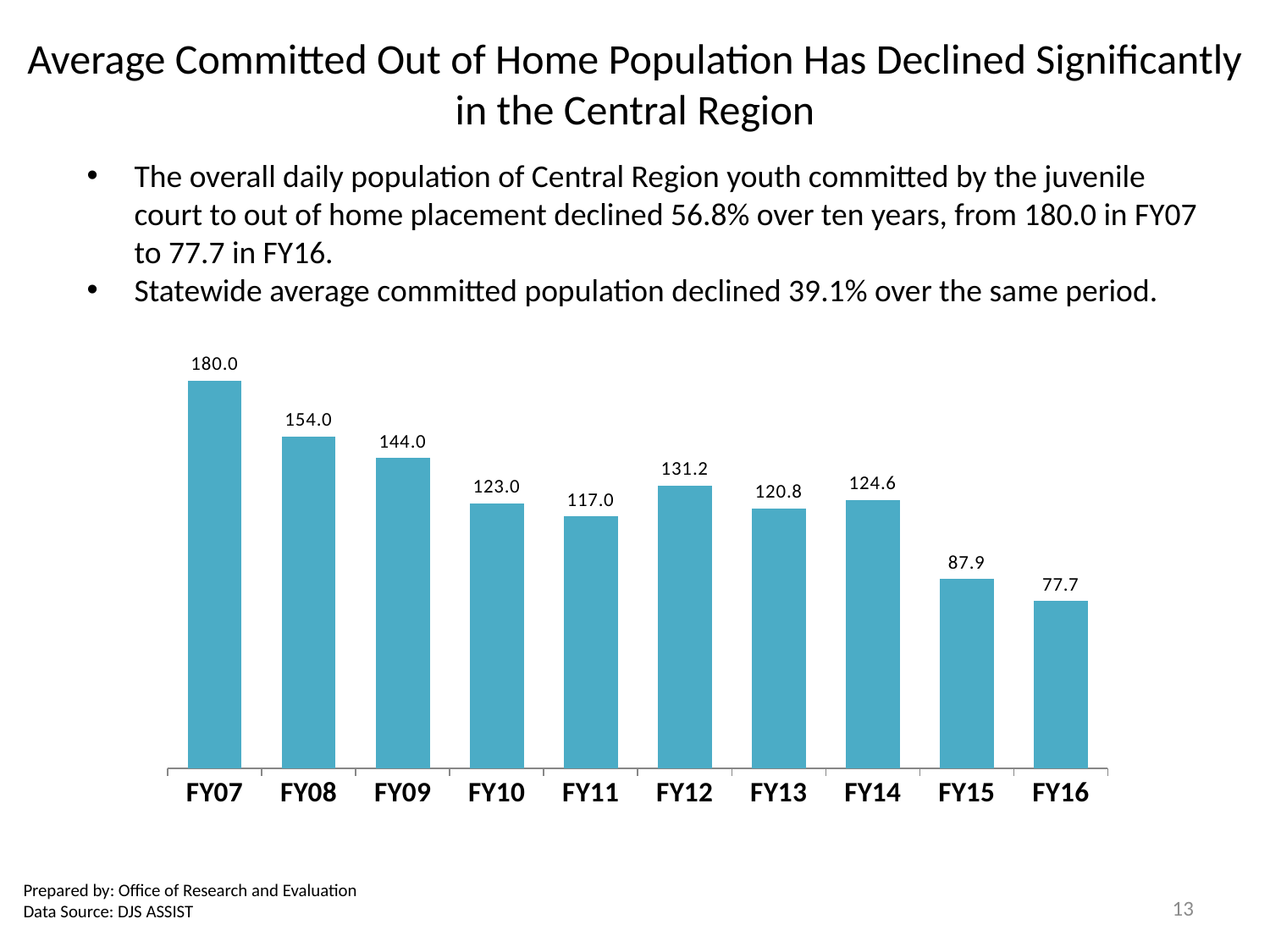
Which is larger, the value for FY12 or the value for FY13? FY12 Do the values generally rise or fall from FY07 to FY16? fall What kind of chart is shown on the slide? bar chart What is the difference between the values for FY07 and FY16? 102.3 What is the value for FY15? 87.9 Which fiscal year has the highest value? FY07 What is the value for FY12? 131.2 Which is larger, the value for FY10 or the value for FY11? FY10 What is the value for FY07? 180.0 What is the difference between the values for FY08 and FY09? 10.0 How many fiscal years are shown on the x axis? 10 Which fiscal year has the lowest value? FY16